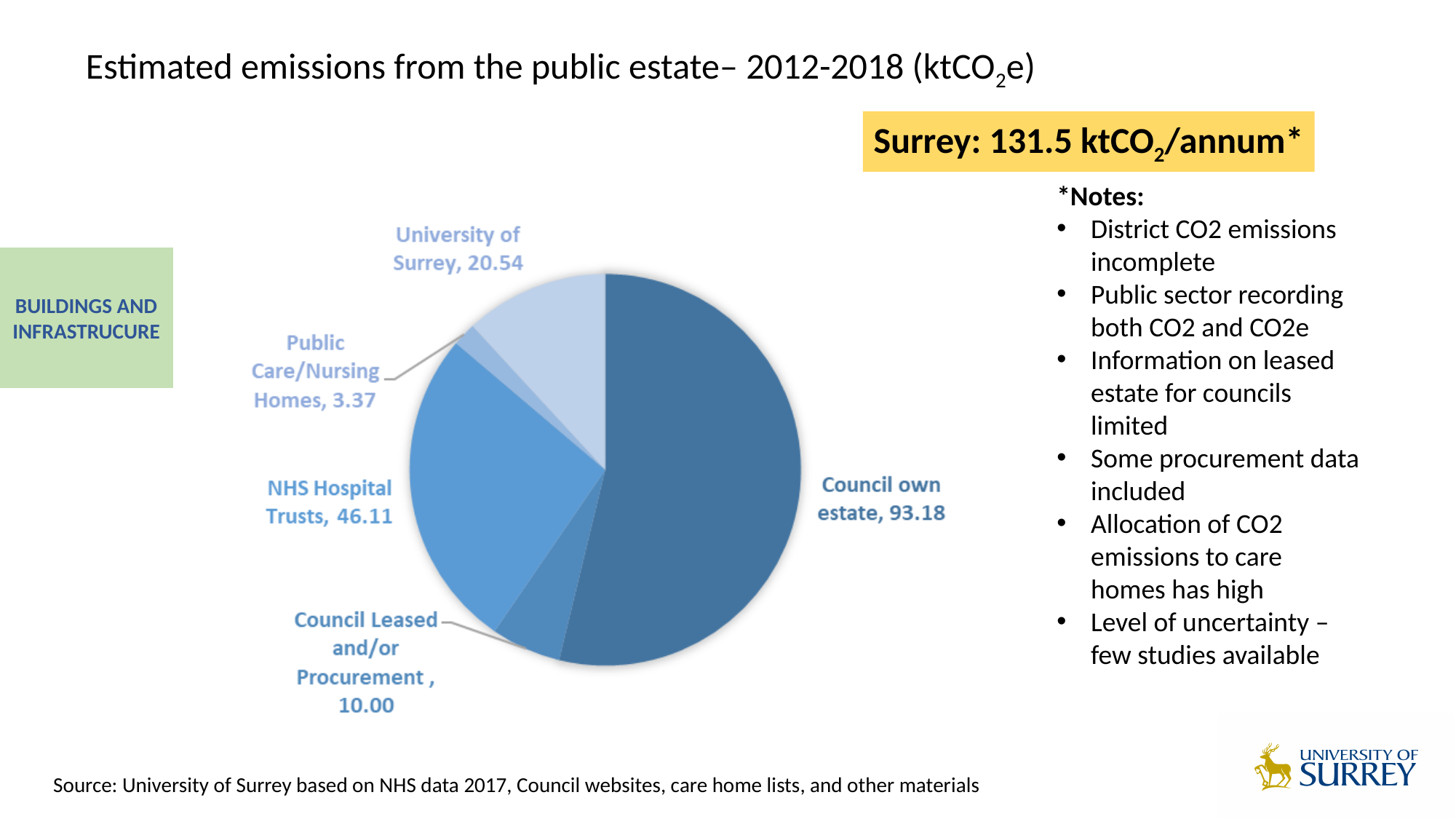
How many categories are shown in the pie chart? 5 What is the value for Public Care/Nursing Homes in the pie chart? 3.37 What is the value for Council Leased and/or Procurement in the pie chart? 10.00 Which is larger, the value for NHS Hospital Trusts or the value for University of Surrey? NHS Hospital Trusts Which category has the smallest slice in the pie chart? Public Care/Nursing Homes What is the value for NHS Hospital Trusts in the pie chart? 46.11 Which category has the largest slice in the pie chart? Council own estate What kind of chart is shown on the slide? Pie chart What is the value for Council own estate in the pie chart? 93.18 What is the value for University of Surrey in the pie chart? 20.54 What is the difference between the values for Council own estate and NHS Hospital Trusts? 47.07 What is the difference between the values for University of Surrey and Council Leased and/or Procurement? 10.54